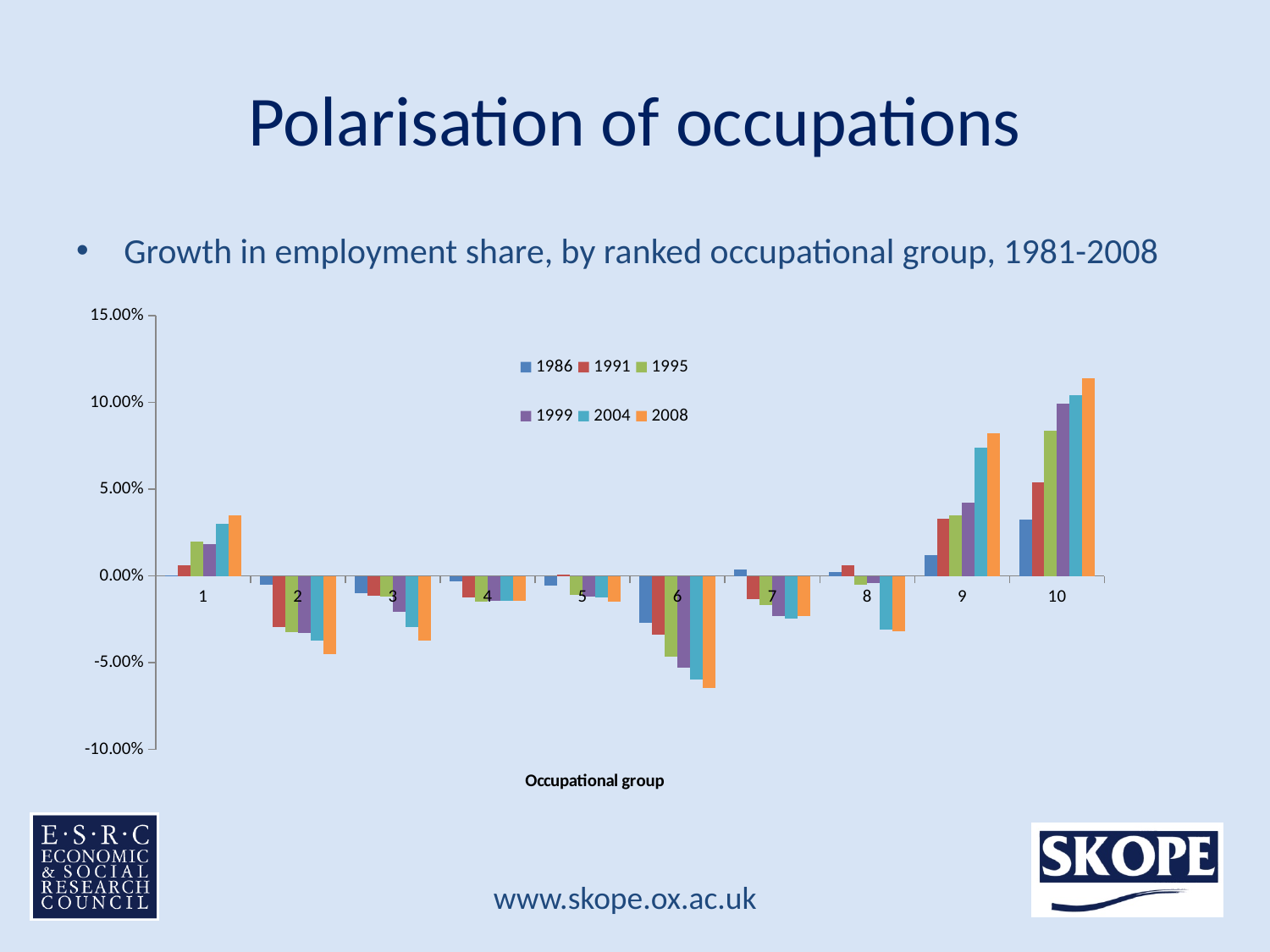
What is the title of the x axis? Occupational group Is the 2008 value for occupational group 10 greater or less than 10.00%? greater Is the 2008 value for occupational group 6 greater or less than -5.00%? less How many occupational groups are shown on the x axis? 10 Which occupational group has the highest value for 2008? 10 What kind of chart is shown on the slide? Bar chart Is the 2008 value for occupational group 9 greater or less than 5.00%? greater For occupational group 10, do the values rise or fall from 1986 to 2008? Rise Which is larger, the 2008 value for occupational group 9 or for occupational group 10? Occupational group 10 How many series does the legend list? 6 Which occupational group has the lowest value for 2008? 6